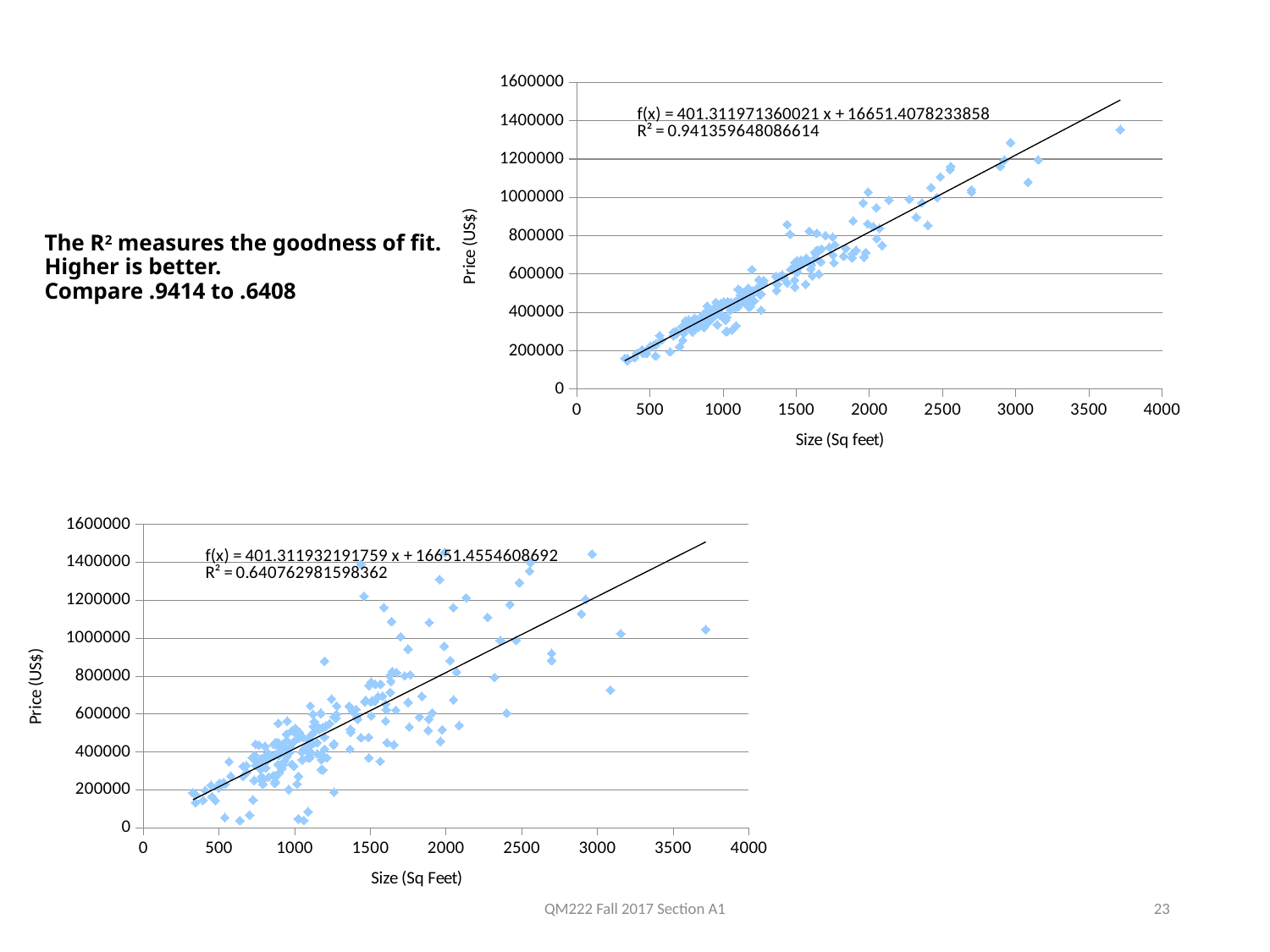
What is the x-axis label of the top chart? Size (Sq feet) In the bottom chart, what is the R² value printed on the chart? 0.640762981598362 In the bottom chart, what is the fitted equation printed on the chart? f(x) = 401.311932191759 x + 16651.4554608692 In the top chart, what is the R² value printed on the chart? 0.941359648086614 What is the y-axis label of the bottom chart? Price (US$) In the top chart, what is the highest value shown on the y axis? 1600000 What kind of chart is the bottom chart on the slide? scatter chart Which chart has the higher R² value, the top chart or the bottom chart? the top chart In the top chart, do prices generally rise or fall as size increases along the x axis? rise In the top chart, what is the fitted equation printed on the chart? f(x) = 401.311971360021 x + 16651.4078233858 In the bottom chart, do prices generally rise or fall as size increases along the x axis? rise What kind of chart is the top chart on the slide? scatter chart